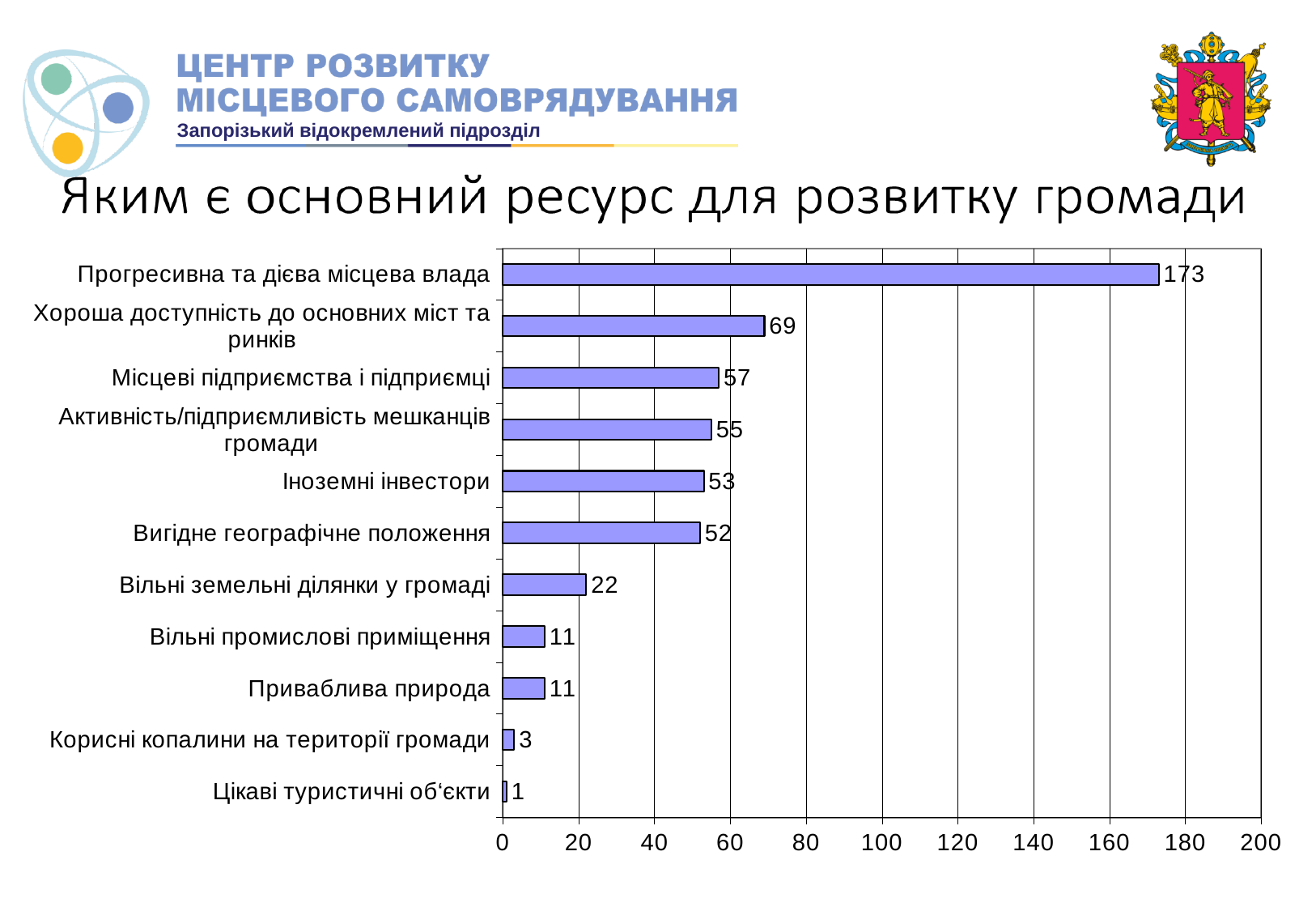
Which category has the highest value? Прогресивна та дієва місцева влада What is the title of the slide above the chart? Яким є основний ресурс для розвитку громади What is the value for "Вільні земельні ділянки у громаді"? 22 What is the value for "Іноземні інвестори"? 53 Which is larger: the value for "Місцеві підприємства і підприємці" or for "Вигідне географічне положення"? Місцеві підприємства і підприємці What kind of chart is shown on the slide? bar chart How many categories are shown in the chart? 11 Which category has the lowest value? Цікаві туристичні об‘єкти Is the value for "Хороша доступність до основних міст та ринків" greater or less than 60? greater What is the difference between the values for "Вільні земельні ділянки у громаді" and "Привабливa природа"? 11 What is the value for "Прогресивна та дієва місцева влада"? 173 What is the difference between the values for "Прогресивна та дієва місцева влада" and "Хороша доступність до основних міст та ринків"? 104